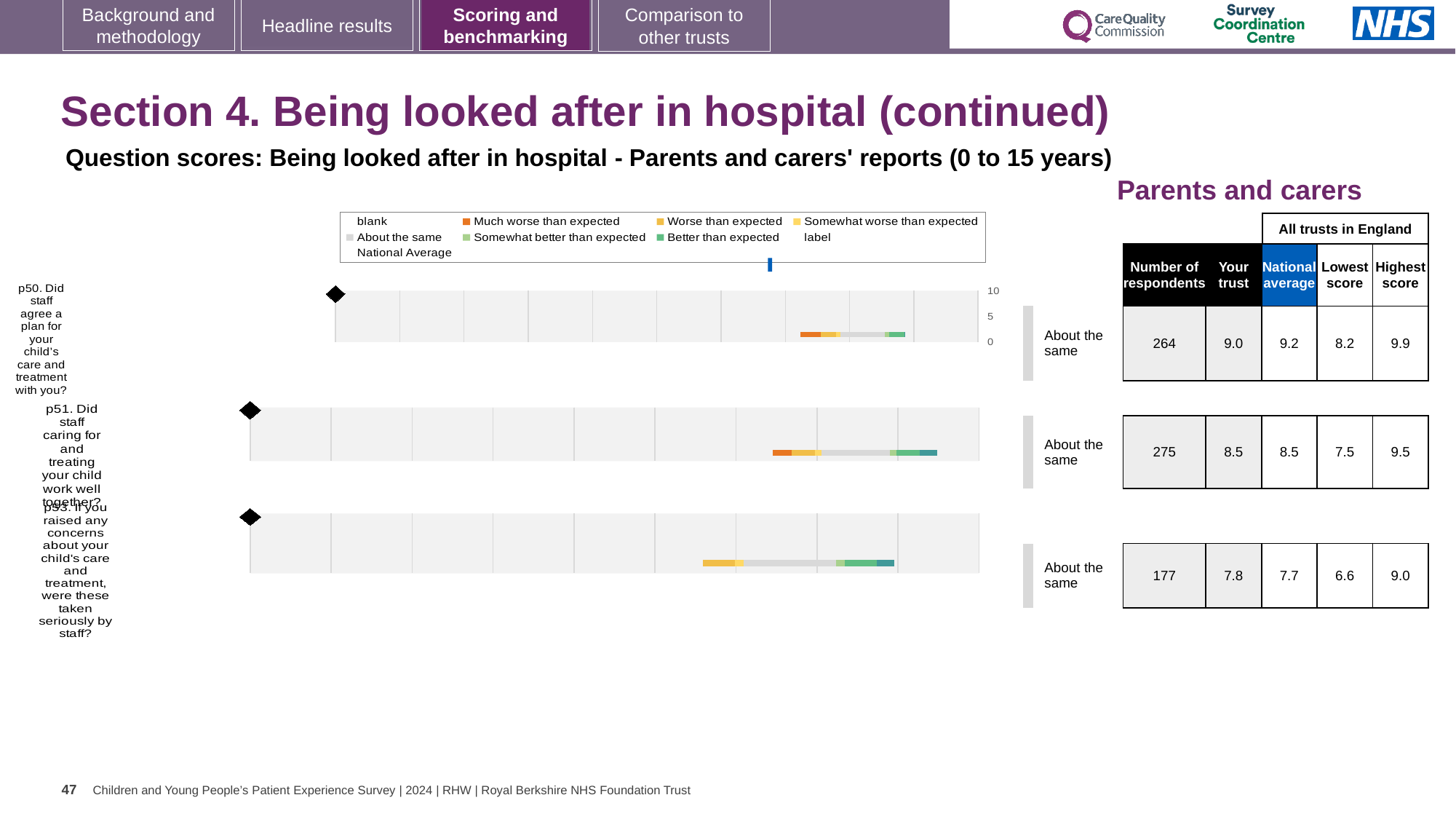
What is the 'Your trust' score for p50 (Did staff agree a plan for your child's care and treatment with you?)? 9.0 Which question has the highest 'Your trust' score? p50 Which question has the lowest number of respondents? p53 For p53, what is the difference between the highest score and the lowest score across all trusts in England? 2.4 What is the lowest score across all trusts in England for p50? 8.2 What kind of chart is used to show the question scores on this slide? bar chart How many respondents answered p53 (If you raised any concerns about your child's care and treatment, were these taken seriously by staff?)? 177 What is the highest value shown on the score axis of the charts? 10 What is the national average score for p51 (Did staff caring for and treating your child work well together?)? 8.5 For p50, which is larger: the 'Your trust' score or the national average? National average How many questions (p50, p51, p53) are plotted on this slide? 3 What benchmark category is the trust placed in for p51? About the same